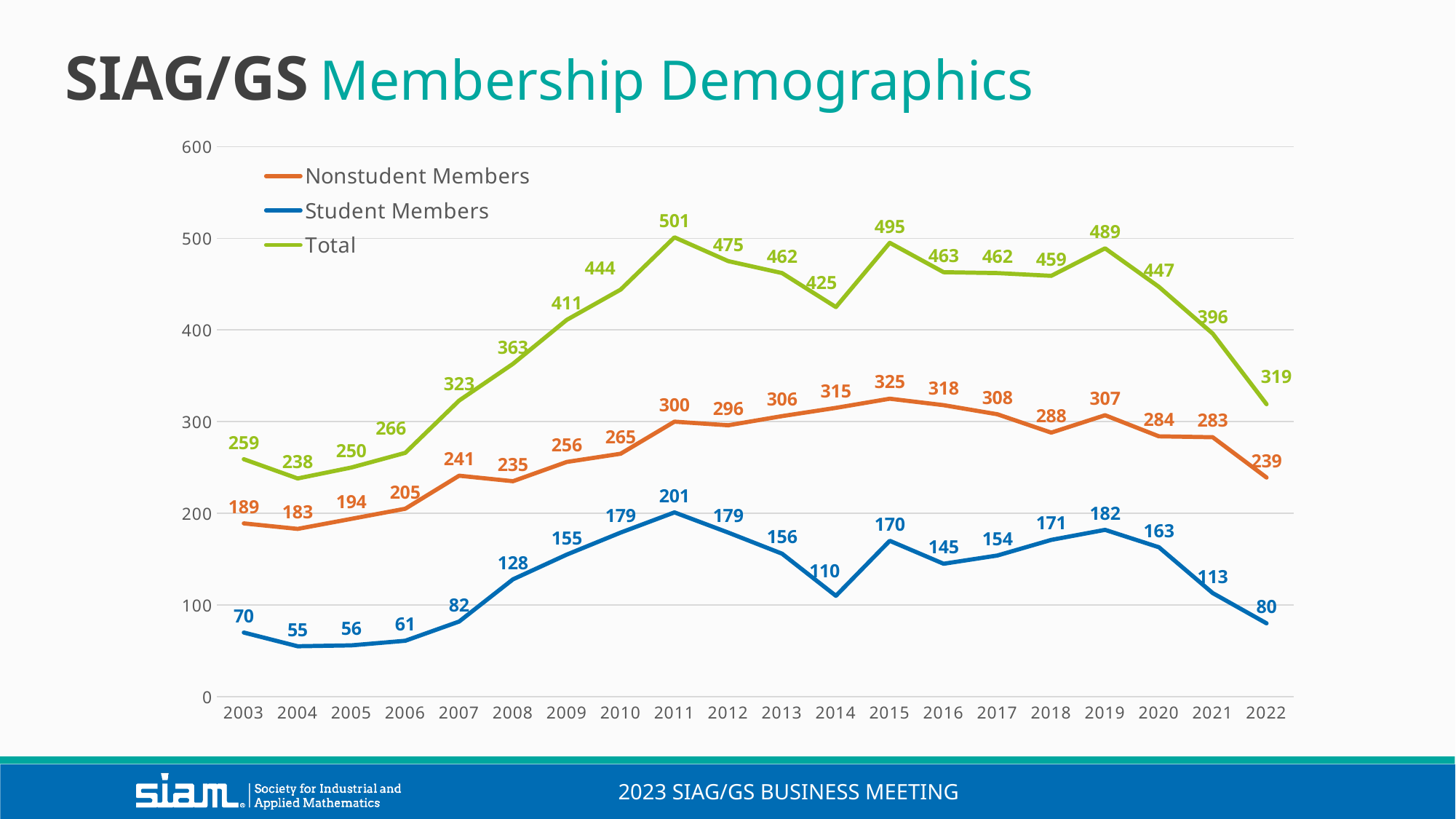
By how much did the Total fall from 2021 to 2022? 77 In which year is the Total series at its highest? 2011 What is the Total membership value for 2011? 501 What is the difference between the Nonstudent Members values for 2021 and 2022? 44 What kind of chart is shown on the slide? Line chart How many years are plotted on the x axis? 20 How many Student Members were there in 2014? 110 Does the Total series rise or fall from 2019 to 2022? Fall In which year is the Student Members series at its lowest? 2004 What is the Nonstudent Members value for 2015? 325 Which year has the larger Student Members value, 2011 or 2019? 2011 How many series does the legend list? 3